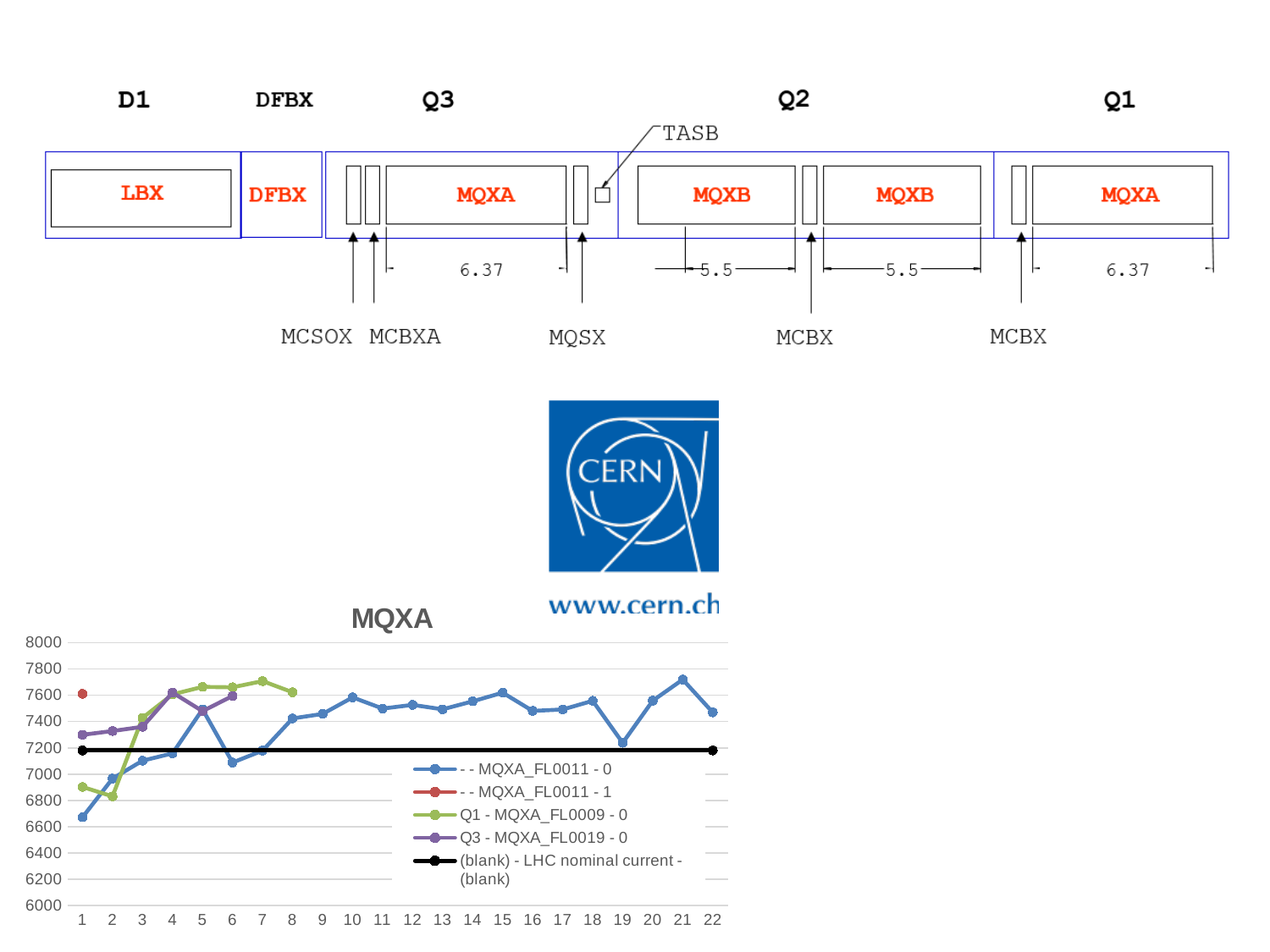
How many points are labelled on the x axis of the MQXA chart? 22 What kind of chart is the MQXA chart? line chart Is the value of the - - MQXA_FL0011 - 0 series at point 1 greater or less than 6800? less How many series does the legend of the MQXA chart list? 5 Which series in the MQXA chart is drawn as a black horizontal line? (blank) - LHC nominal current - (blank) What is the title of the chart on the slide? MQXA Is the value of the Q1 - MQXA_FL0009 - 0 series at point 2 greater or less than 7000? less At point 1, which series has the higher value: Q3 - MQXA_FL0019 - 0 or - - MQXA_FL0011 - 0? Q3 - MQXA_FL0019 - 0 Is the value of the Q3 - MQXA_FL0019 - 0 series at point 1 greater or less than 7200? greater Does the - - MQXA_FL0011 - 0 series rise or fall from point 1 to point 5? rise At which x-axis point does the - - MQXA_FL0011 - 0 series reach its highest value? 21